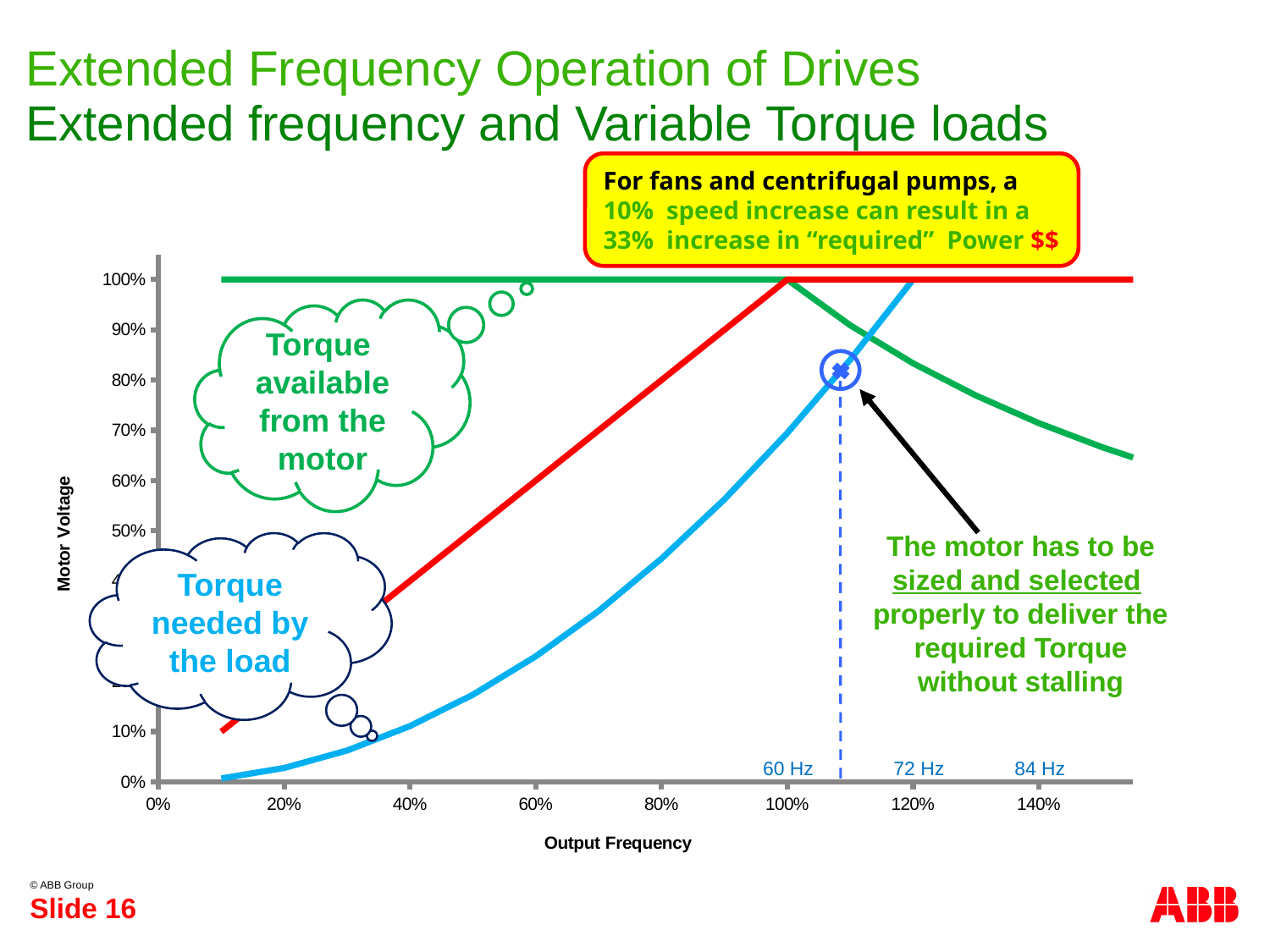
How many lines are plotted on the chart? 3 Does the blue 'Torque needed by the load' line rise or fall as output frequency increases? rise What is the title of the x axis of the chart? Output Frequency Is the value of the green 'Torque available from the motor' line at 140% output frequency greater or less than 80%? less What motor voltage does the red line reach at 100% output frequency? 100% Does the green 'Torque available from the motor' line rise or fall as output frequency increases beyond 100%? fall At 120% output frequency, which line has the higher value, the red line or the green line? red line Is the value of the blue 'Torque needed by the load' line at 60% output frequency greater or less than 50%? less What kind of chart is shown on the slide? line chart What is the title of the y axis of the chart? Motor Voltage Is the value of the red line at 60% output frequency greater or less than 50%? greater What is the value of the green 'Torque available from the motor' line at 60% output frequency? 100%